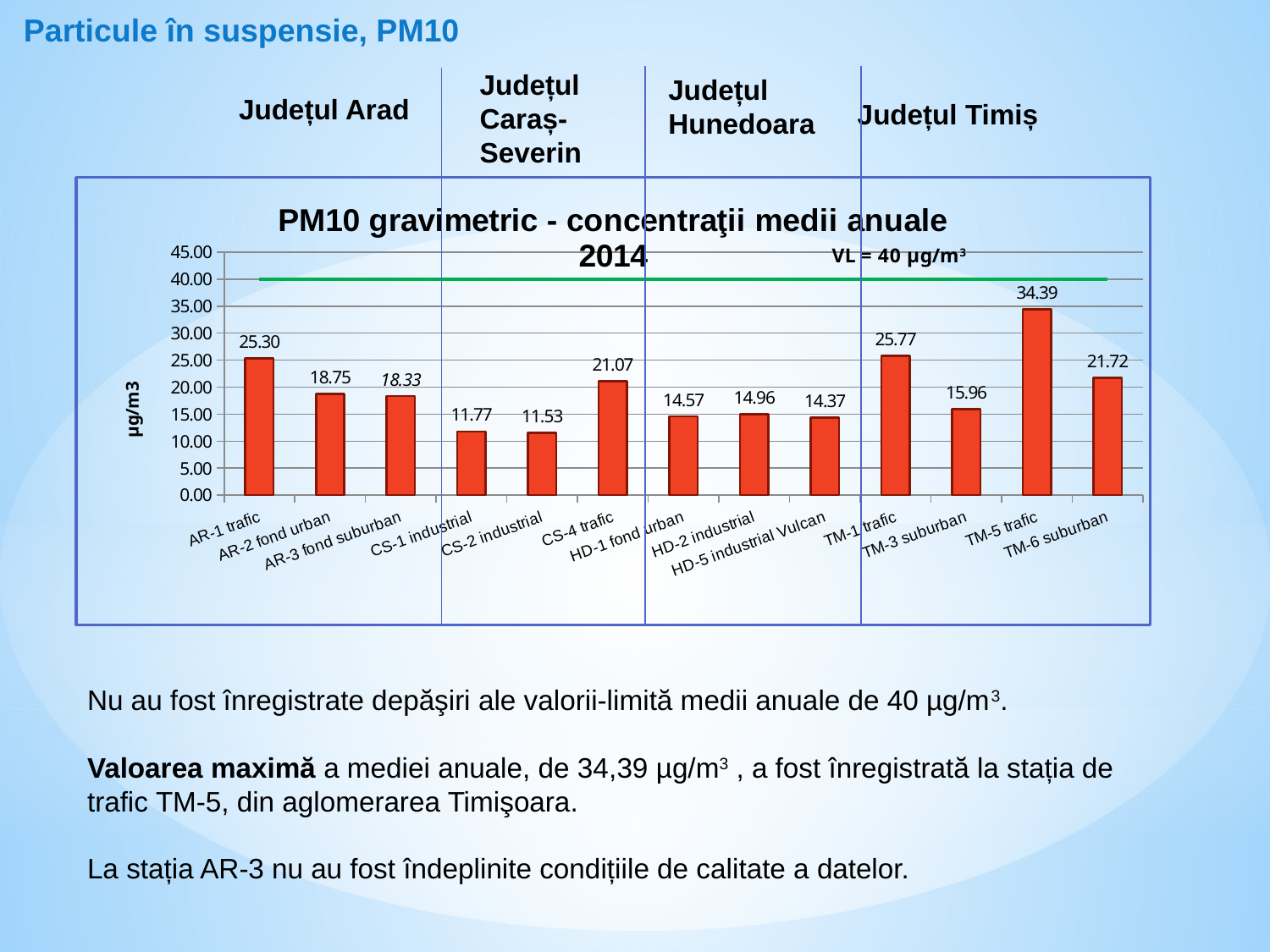
Which is larger, the value for CS-4 trafic or the value for TM-6 suburban? TM-6 suburban How many stations (bars) are shown in the chart? 13 What is the difference between the values for AR-1 trafic and AR-2 fond urban? 6.55 What is the value for HD-2 industrial? 14.96 What is the value for CS-1 industrial? 11.77 Which station has the highest PM10 annual mean concentration? TM-5 trafic What limit value (VL) does the green horizontal line represent? VL = 40 µg/m³ What is the difference between the values for TM-5 trafic and TM-1 trafic? 8.62 What is the value for TM-5 trafic? 34.39 Is the value for TM-5 trafic greater or less than 40? less Which station has the lowest PM10 annual mean concentration? CS-2 industrial What kind of chart is shown on the slide? bar chart